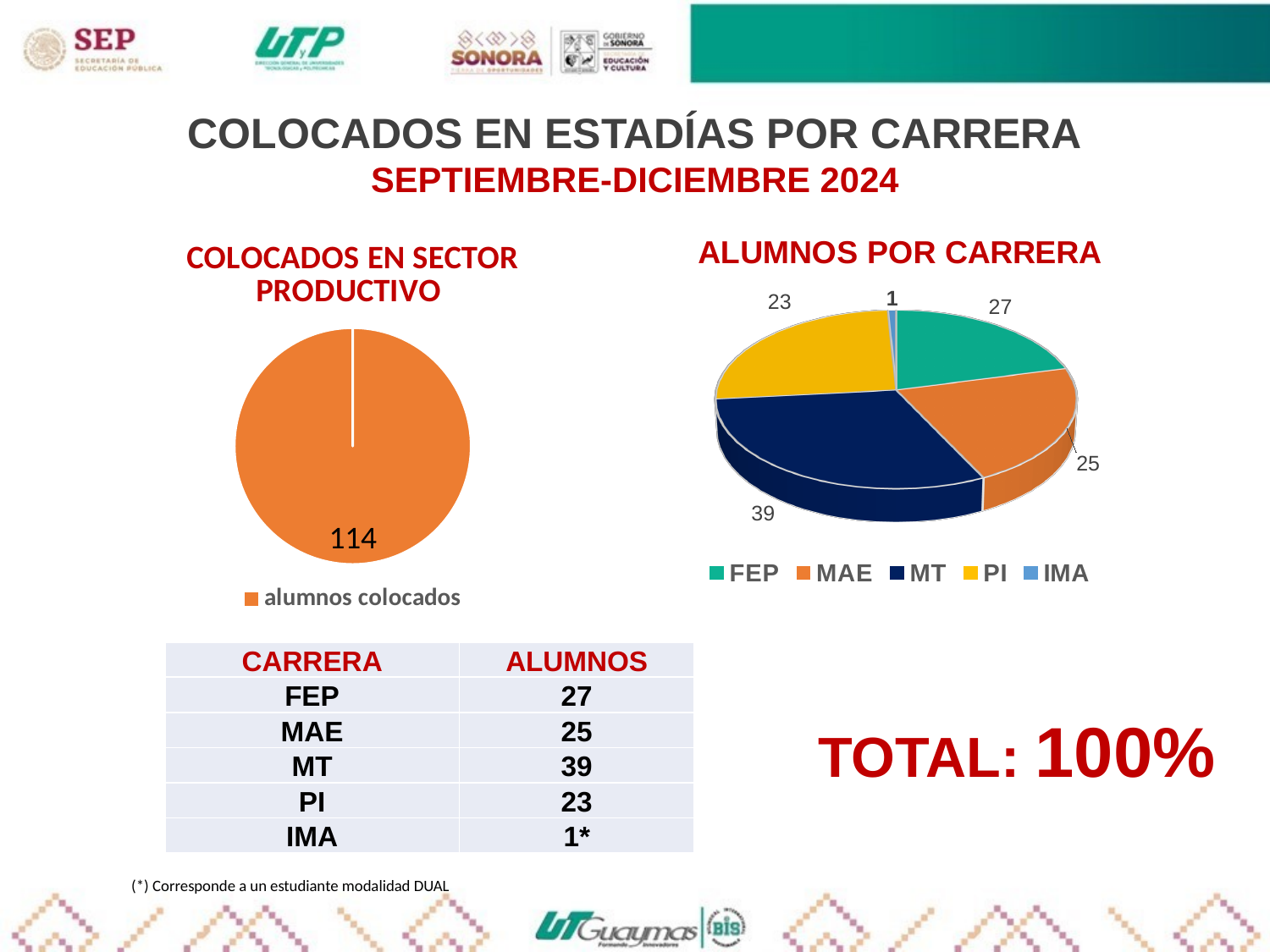
In the ALUMNOS POR CARRERA chart, how many students are in MT? 39 What value is shown on the COLOCADOS EN SECTOR PRODUCTIVO pie chart? 114 How many slices does the ALUMNOS POR CARRERA pie chart have? 5 In the ALUMNOS POR CARRERA chart, which carrera has the smallest slice? IMA In the ALUMNOS POR CARRERA chart, what is the difference between MT and PI? 16 In the ALUMNOS POR CARRERA chart, what is the value for IMA? 1 What type of chart is the COLOCADOS EN SECTOR PRODUCTIVO chart? Pie chart In the ALUMNOS POR CARRERA chart, what is the value for PI? 23 How many entries does the legend of the ALUMNOS POR CARRERA chart list? 5 In the ALUMNOS POR CARRERA chart, which is larger, FEP or MAE? FEP In the ALUMNOS POR CARRERA chart, which carrera has the largest slice? MT What is the legend entry of the COLOCADOS EN SECTOR PRODUCTIVO chart? alumnos colocados